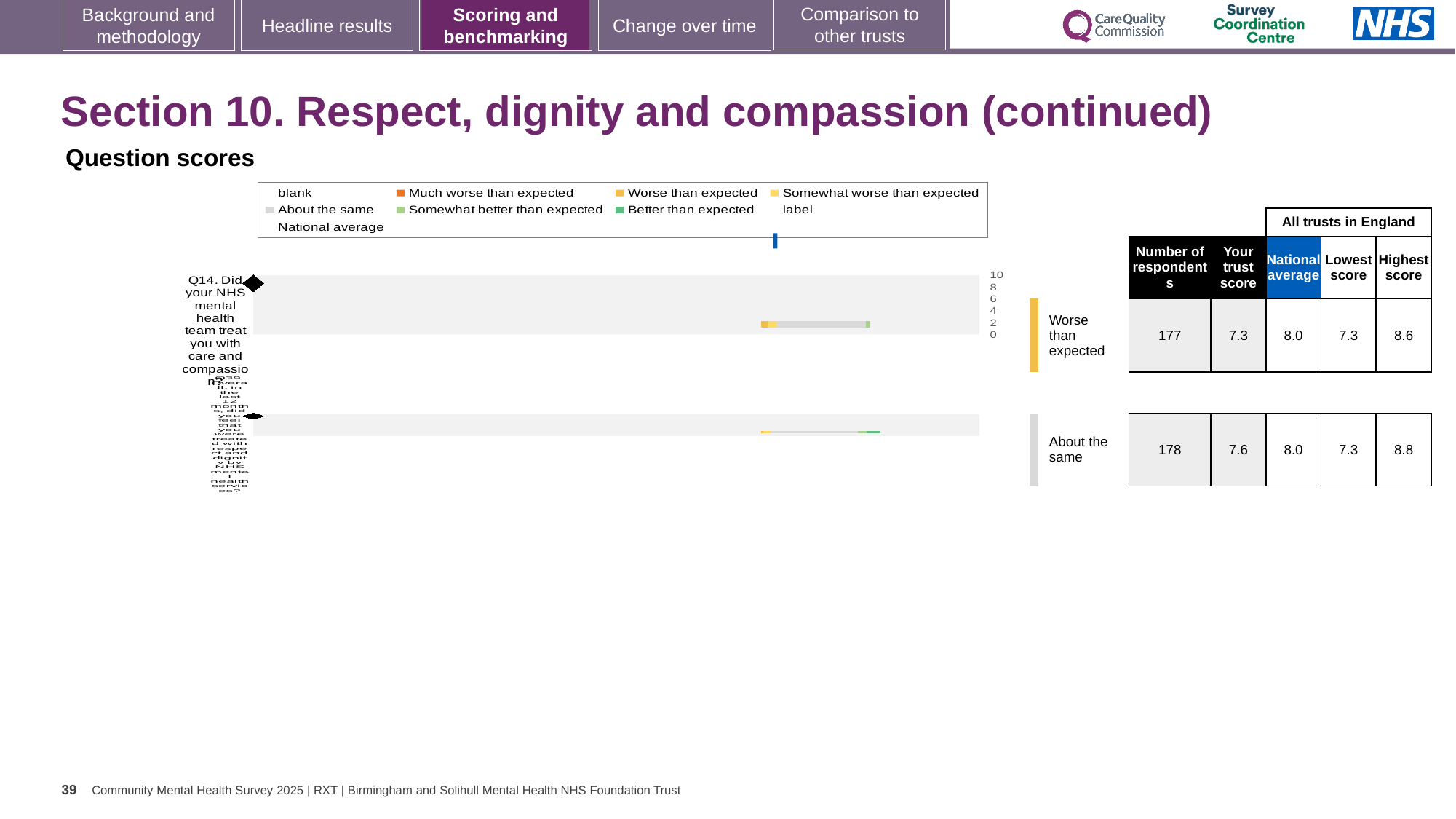
What is the national average for Q14? 8.0 What is 'Your trust score' for the second question row (Q39)? 7.6 What is 'Your trust score' for Q14 (care and compassion)? 7.3 How many question rows are plotted in the chart? 2 What is the number of respondents for Q14? 177 What is the highest score among all trusts in England for Q14? 8.6 By how much is the national average higher than the trust score for Q14? 0.7 What is the highest score among all trusts in England for the second question row (Q39)? 8.8 What is the number of respondents for the second question row (Q39)? 178 What benchmark category is shown for Q14? Worse than expected Which question row has the higher trust score, Q14 or the second row (Q39)? Q39 What kind of chart is shown under 'Question scores'? bar chart